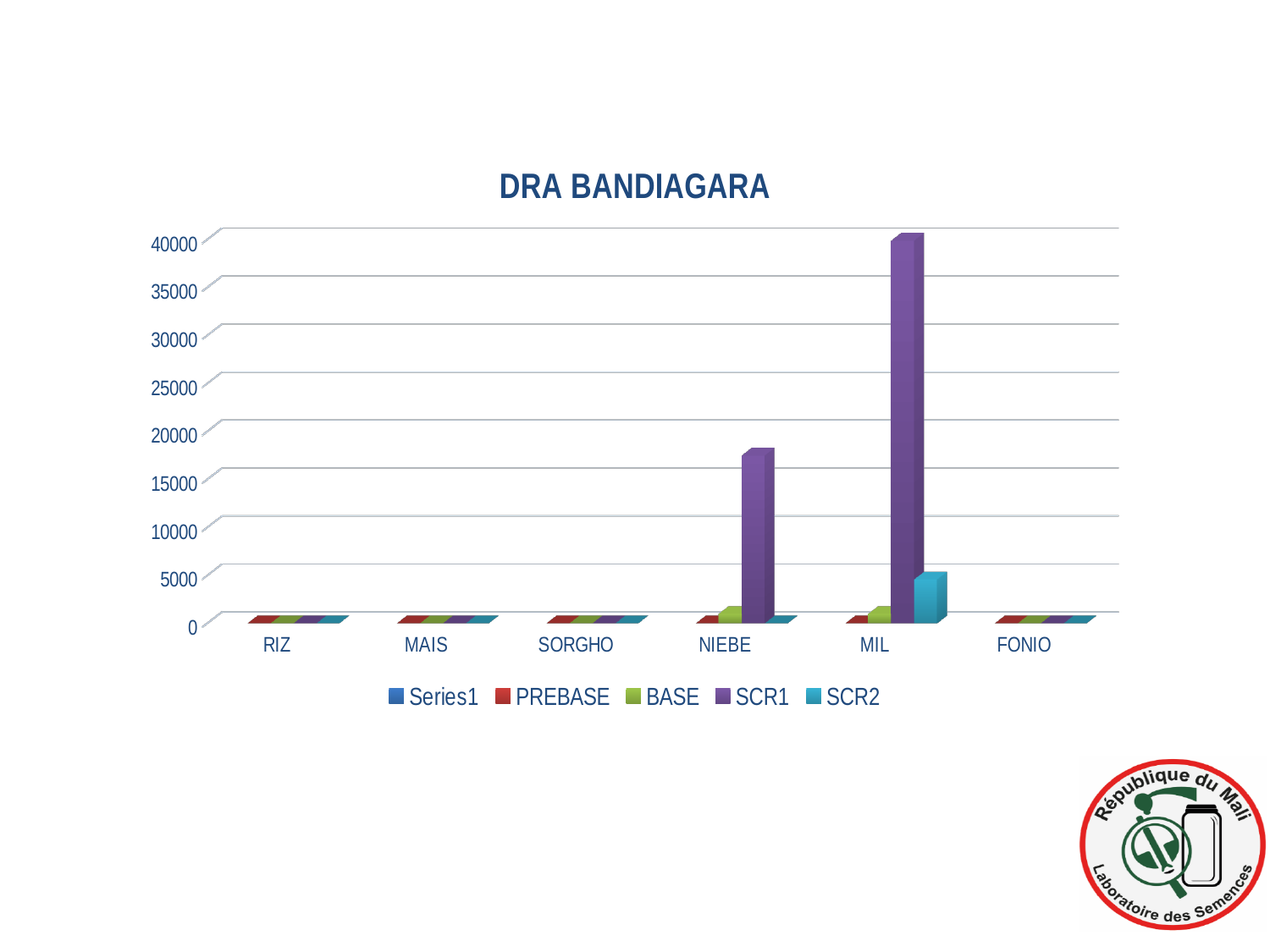
How many series does the legend list? 5 Is the SCR2 value for MIL greater or less than 10000? less What kind of chart is shown on the slide? bar chart Is the SCR1 value for MIL greater or less than 35000? greater Which category has the highest SCR1 value? MIL What is the title of the chart? DRA BANDIAGARA How many categories are shown on the x axis? 6 Which is larger, the SCR1 value for NIEBE or the SCR1 value for MIL? MIL Which is larger for MIL, the SCR1 value or the SCR2 value? SCR1 Is the SCR1 value for NIEBE greater or less than 20000? less What colour represents the SCR1 series in the legend? purple